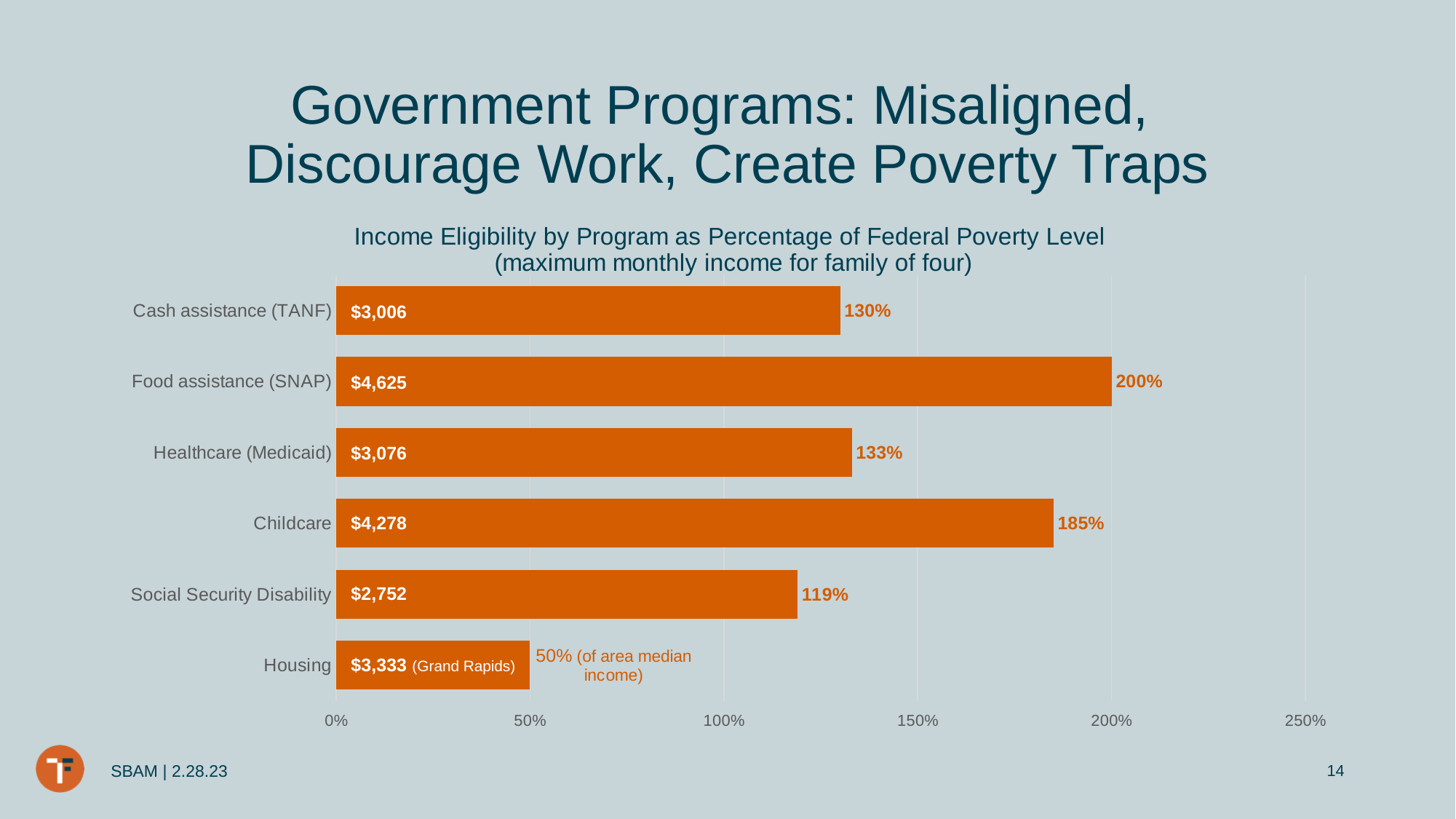
What percentage of the Federal Poverty Level is the income eligibility limit for Food assistance (SNAP)? 200% What type of chart is shown on the slide? Bar chart What is the maximum monthly income for a family of four shown for Childcare? $4,278 How many programs are listed on the chart? 6 What maximum monthly income is shown for Healthcare (Medicaid)? $3,076 Which program has the highest income eligibility as a percentage of the Federal Poverty Level? Food assistance (SNAP) What percentage is shown for Social Security Disability? 119% What is the title of the chart? Income Eligibility by Program as Percentage of Federal Poverty Level (maximum monthly income for family of four) What is the difference in percentage points between Food assistance (SNAP) and Cash assistance (TANF)? 70% Which program has the shortest bar on the chart? Housing Which has a higher percentage, Childcare or Healthcare (Medicaid)? Childcare Is the value for Social Security Disability greater or less than 100%? greater